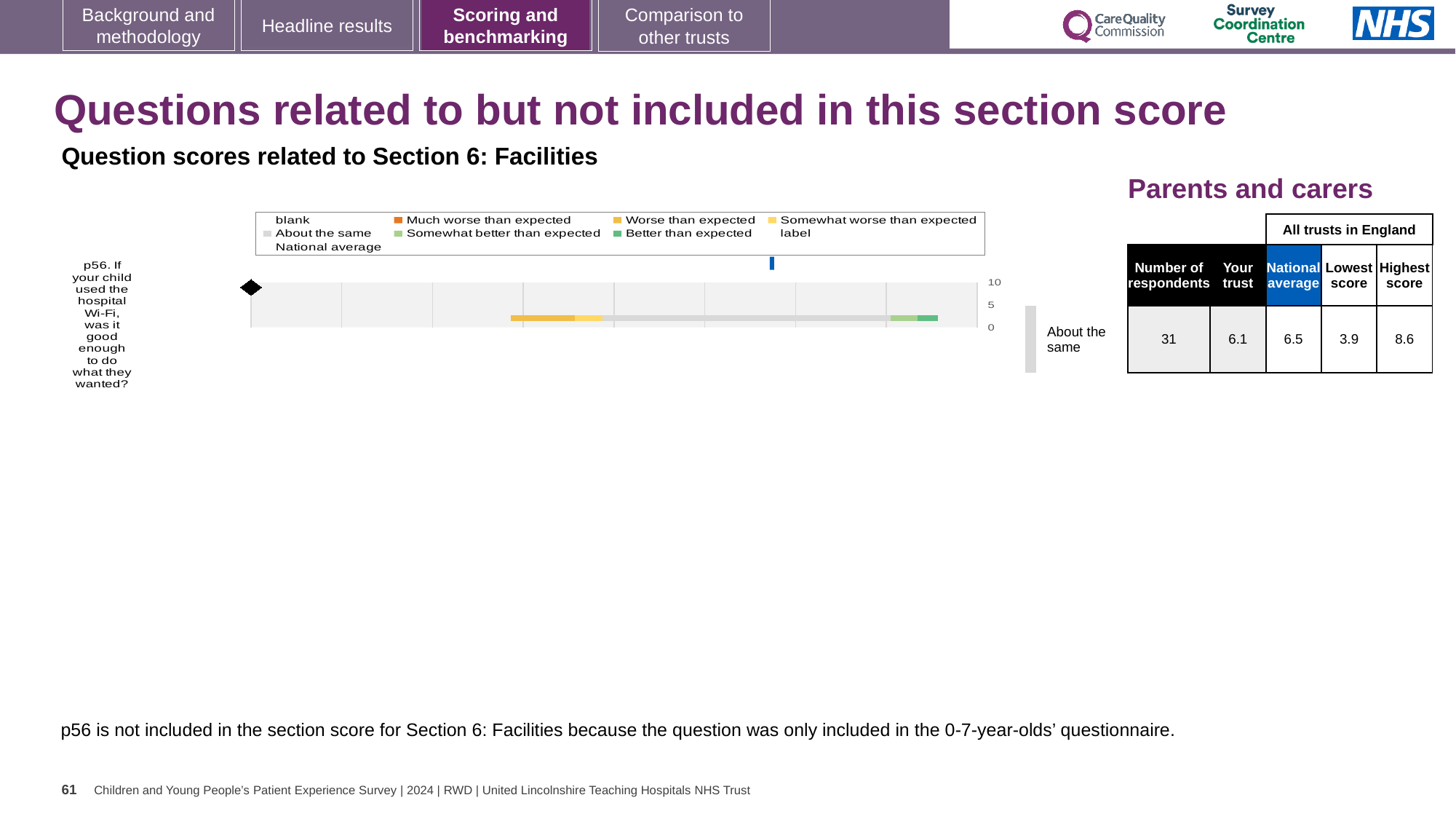
Which question is plotted on the chart? p56. If your child used the hospital Wi-Fi, was it good enough to do what they wanted? What is the number of respondents for p56? 31 What is the highest score among all trusts in England for p56? 8.6 What is the 'Your trust' score for p56? 6.1 Which is larger for p56, the 'Your trust' score or the national average? National average How many survey questions are plotted on the chart? 1 What is the difference between the highest and lowest scores for p56 across all trusts in England? 4.7 What is the national average score for p56? 6.5 What is the highest value shown on the chart's axis? 10 What kind of chart is shown on the slide? bar chart What is the difference between the national average and the 'Your trust' score for p56? 0.4 What is the lowest score among all trusts in England for p56? 3.9